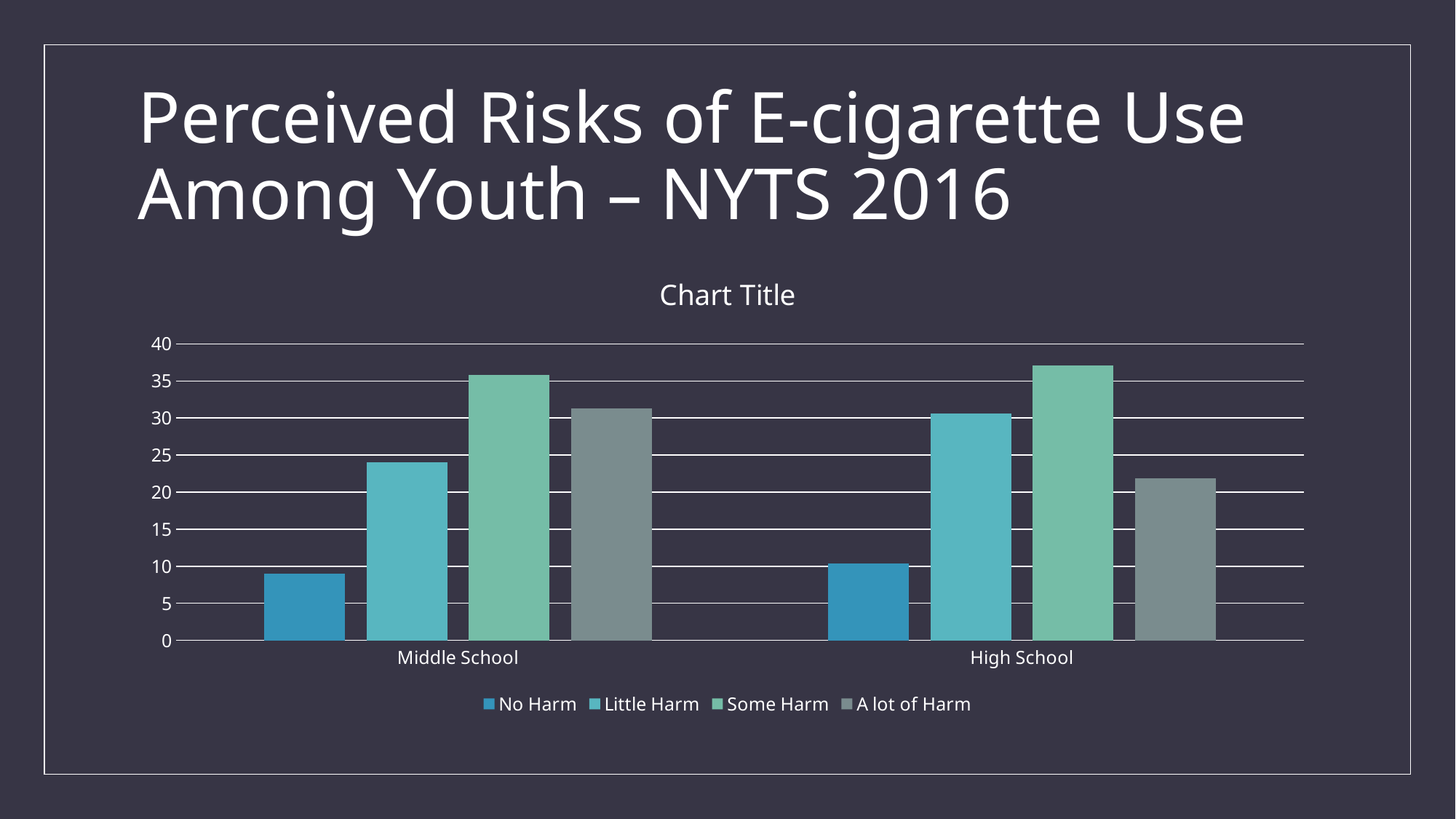
How many categories are shown on the x axis? 2 Which is larger: Little Harm for Middle School or Little Harm for High School? High School What kind of chart is shown on the slide? bar chart Is the value for A lot of Harm in High School greater or less than 25? less Which is larger: A lot of Harm for Middle School or A lot of Harm for High School? Middle School Is the value for Some Harm in Middle School greater or less than 35? greater Is the value for Little Harm in High School greater or less than 30? greater Which series has the highest value for Middle School? Some Harm Which series has the lowest value for High School? No Harm What is the title shown above the chart? Chart Title How many series does the legend list? 4